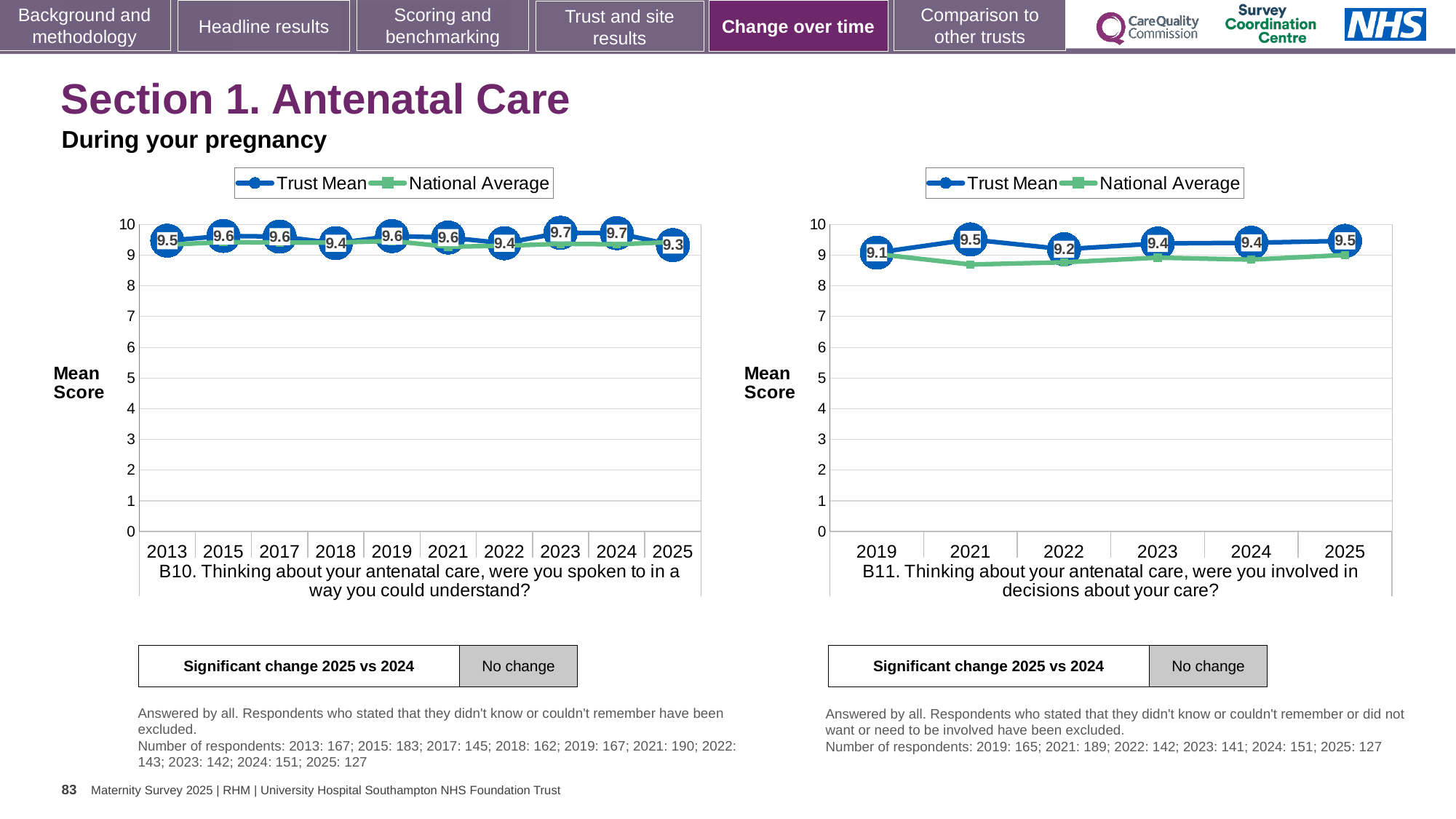
In the B10 chart on the left, what is the difference between the Trust Mean for 2024 and 2025? 0.4 In the B10 chart on the left, what is the Trust Mean for 2013? 9.5 In the B11 chart on the right, is the Trust Mean higher in 2025 or in 2019? 2025 How many series does the legend of the B11 chart on the right list? 2 In the B11 chart on the right, what is the Trust Mean for 2023? 9.4 In the B10 chart on the left, what is the Trust Mean for 2025? 9.3 In the B11 chart on the right, what is the Trust Mean for 2019? 9.1 How many years are plotted in the B10 chart on the left? 10 In the B11 chart on the right, which year has the lowest Trust Mean? 2019 What type of chart is the B10 chart on the left? Line chart In the B11 chart on the right, is the National Average for 2021 greater or less than 9? less In the B10 chart on the left, which year has the lowest Trust Mean? 2025